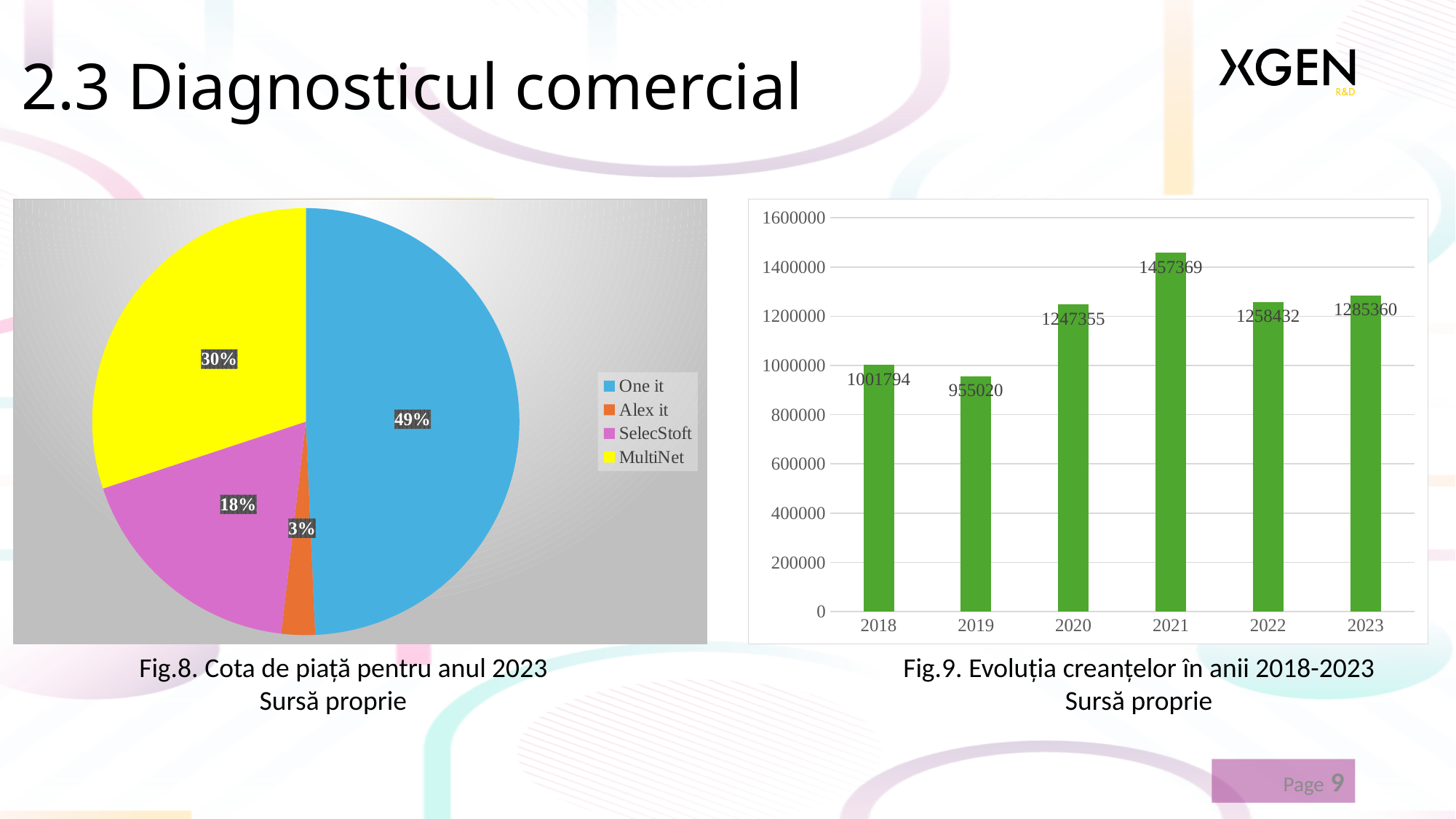
In the bar chart (Fig.9), what is the value for 2021? 1457369 In the pie chart (Fig.8), how many companies are listed in the legend? 4 In the bar chart (Fig.9), which year has the highest value? 2021 In the pie chart (Fig.8), what share does MultiNet hold? 30% In the pie chart (Fig.8), what share does One it hold? 49% In the bar chart (Fig.9), what is the difference between the values for 2023 and 2022? 26928 In the pie chart (Fig.8), what is the difference between the shares of MultiNet and SelecStoft? 12% In the pie chart (Fig.8), which company has the smallest share? Alex it In the bar chart (Fig.9), what is the value for 2019? 955020 In the bar chart (Fig.9), how many years are shown on the x axis? 6 What type of chart is Fig.9? Bar chart In the bar chart (Fig.9), which year has the lowest value? 2019